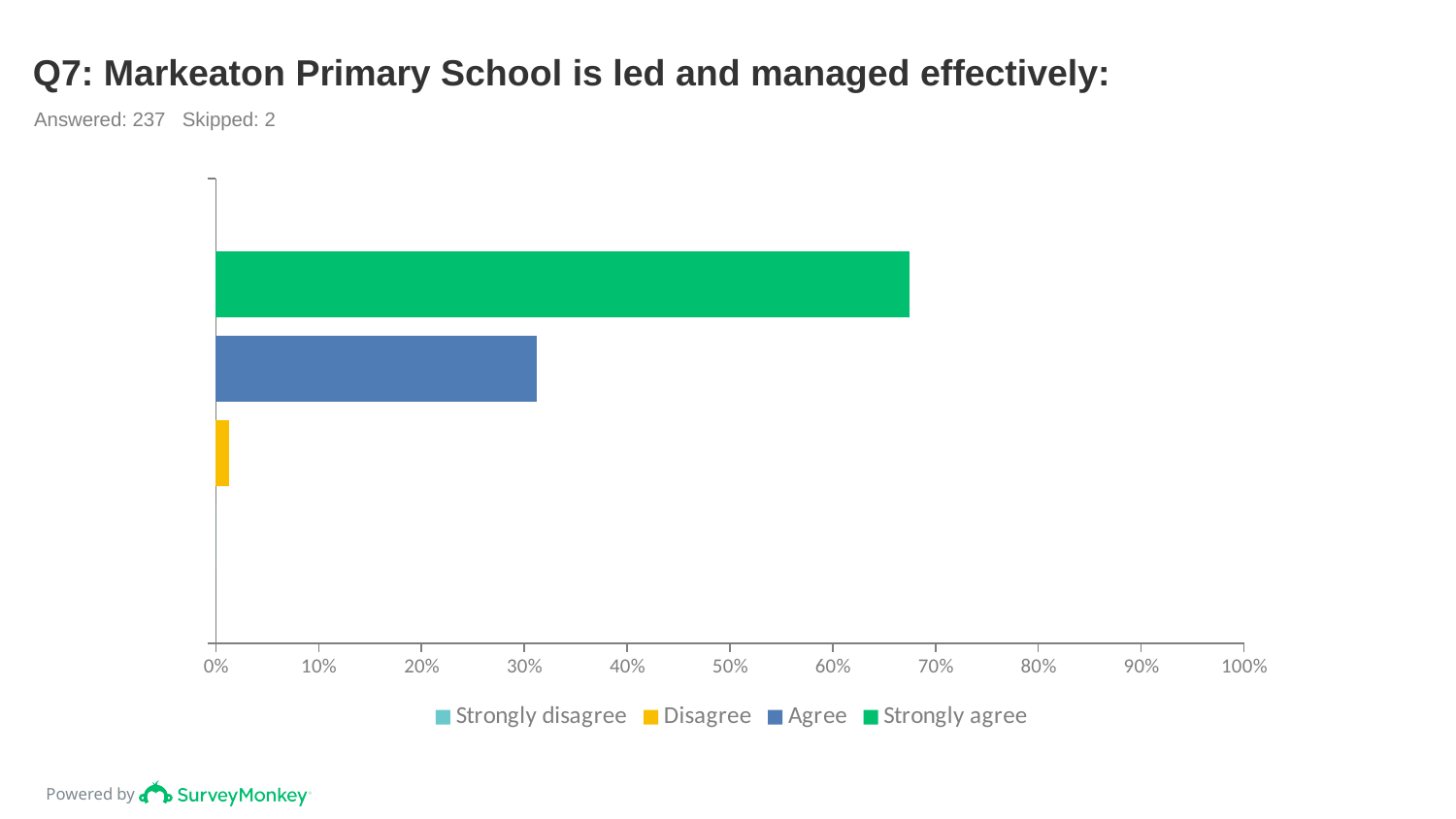
Is the value for Agree greater or less than 30%? greater Is the value for Strongly agree greater or less than 60%? greater How many series does the legend list? 4 Is the value for Agree greater or less than 40%? less Which is larger, the value for Agree or the value for Strongly agree? Strongly agree What is the title of the chart? Q7: Markeaton Primary School is led and managed effectively: What kind of chart is shown on the slide? bar chart Which is larger, the value for Disagree or the value for Agree? Agree Which response has the highest value? Strongly agree How many respondents answered this question according to the slide? 237